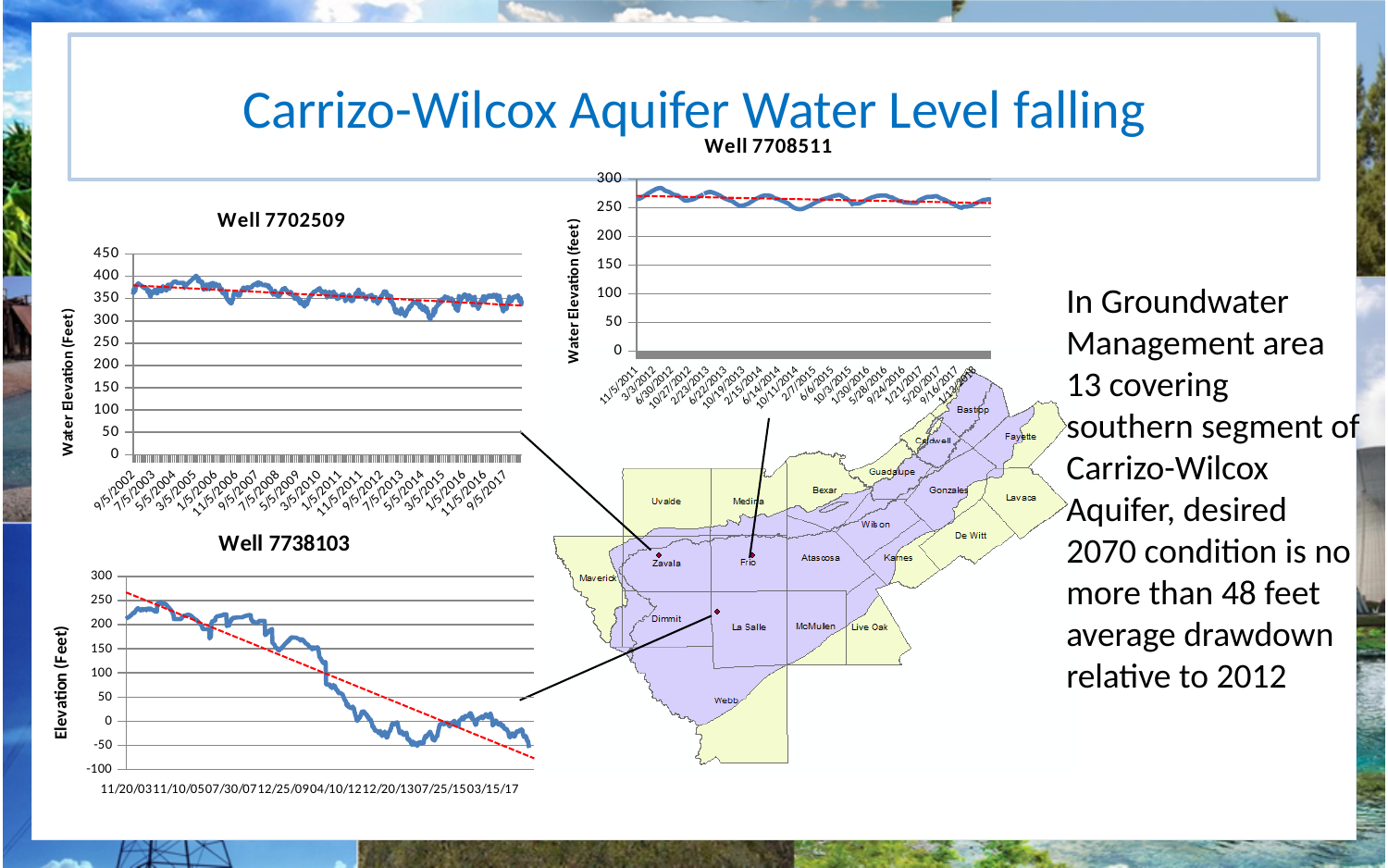
In the Well 7708511 chart, is the water elevation at the end of the series greater or less than 200? greater How many charts are shown on the slide? 3 Which of the three wells shows the steepest decline in water elevation over its period? Well 7738103 In the Well 7702509 chart, is the water elevation at the start of the series (9/5/2002) greater or less than 300? greater What is the maximum value shown on the y axis of the Well 7702509 chart? 450 In the Well 7738103 chart, is the elevation at the end of the series greater or less than 0? less In the Well 7708511 chart, does the dashed trend line rise or fall along the x axis? fall In the Well 7738103 chart, do the elevation values rise or fall over time along the x axis? fall What is the y-axis label of the Well 7738103 chart? Elevation (Feet) In the Well 7702509 chart, do the water elevation values rise or fall over time along the x axis? fall What kind of chart is the Well 7702509 chart? line chart